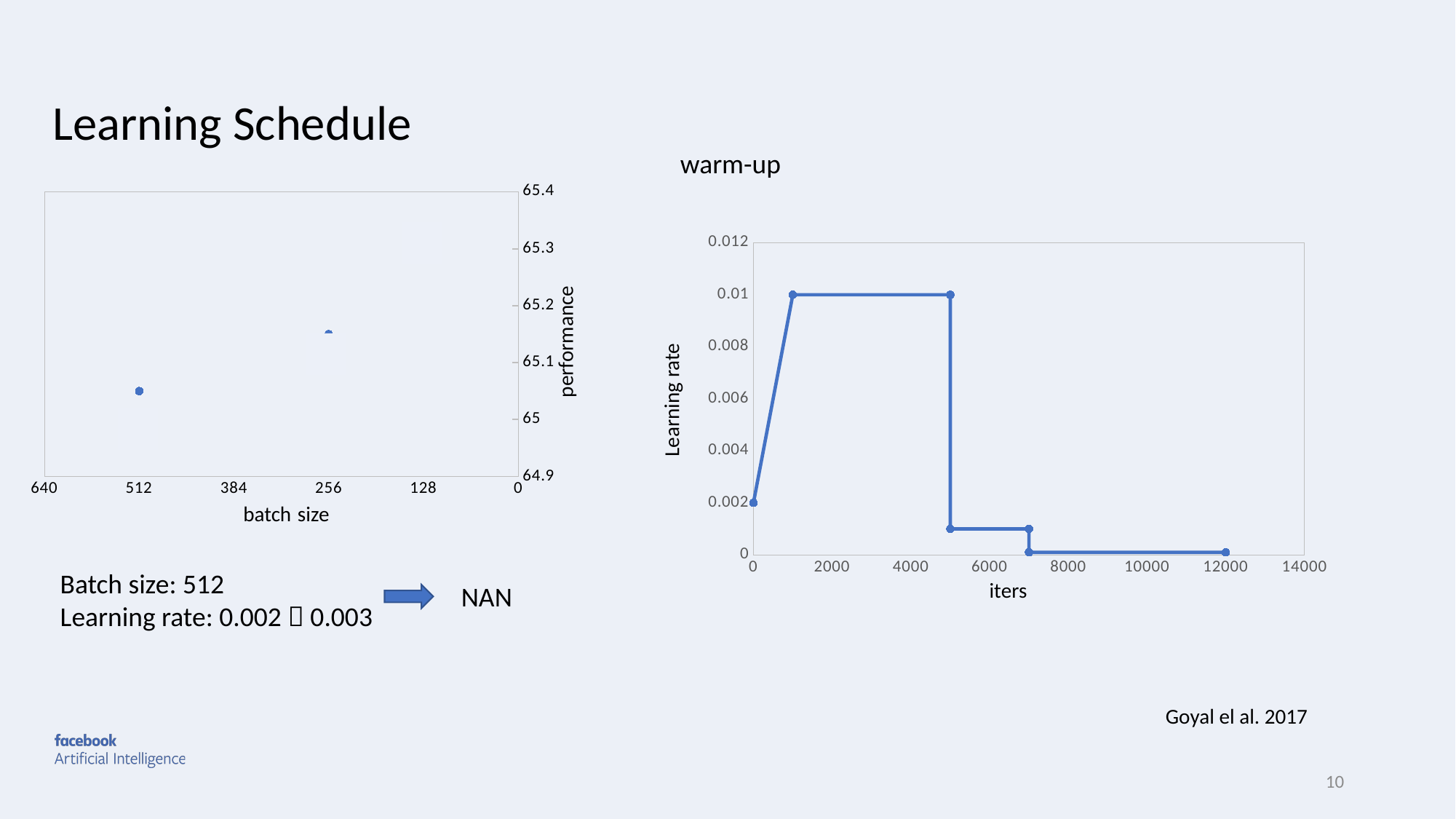
In the 'warm-up' chart, what is the label of the x axis? iters In the left chart of batch size versus performance, which batch size has the higher performance, 512 or 256? 256 In the 'warm-up' chart, is the learning rate at 6000 iters greater or less than 0.002? less In the 'warm-up' chart, what is the learning rate at 0 iters? 0.002 What kind of chart is the 'warm-up' chart on the right of the slide? line chart In the 'warm-up' chart, what is the label of the y axis? Learning rate In the 'warm-up' chart, what is the highest learning rate reached? 0.01 In the 'warm-up' chart, does the learning rate rise or fall between 0 and 1000 iters? rise In the left chart of batch size versus performance, how many data points are plotted? 2 In the 'warm-up' chart, what is the learning rate at 1000 iters? 0.01 In the left chart of batch size versus performance, is the performance for batch size 256 greater or less than 65.1? greater In the 'warm-up' chart, is the learning rate at 3000 iters greater or less than 0.008? greater